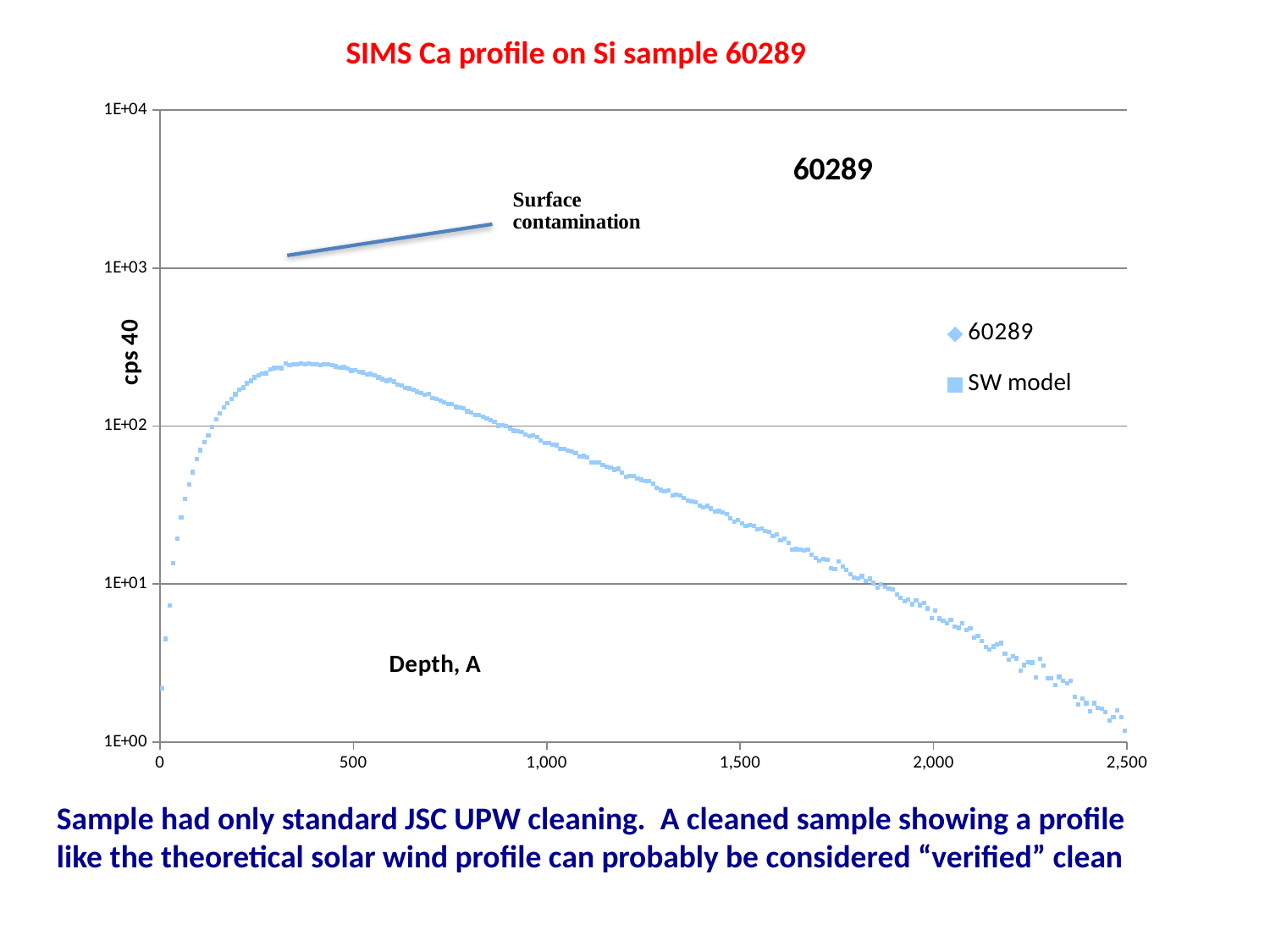
Do the plotted values rise or fall as depth increases from 500 to 2,500? fall Is the plotted value at a depth of 500 greater or less than 1E+03? less How many series does the legend list? 2 What is the label on the y axis of the chart? cps 40 Which is larger, the plotted value at a depth of 500 or at a depth of 2,000? 500 Is the plotted value at a depth of 2,000 greater or less than 1E+01? less Is the plotted value at a depth of 1,000 greater or less than 1E+02? less What is the highest value shown on the y axis of the chart? 1E+04 What kind of chart is shown on the slide? scatter chart What are the two series named in the legend? 60289 and SW model